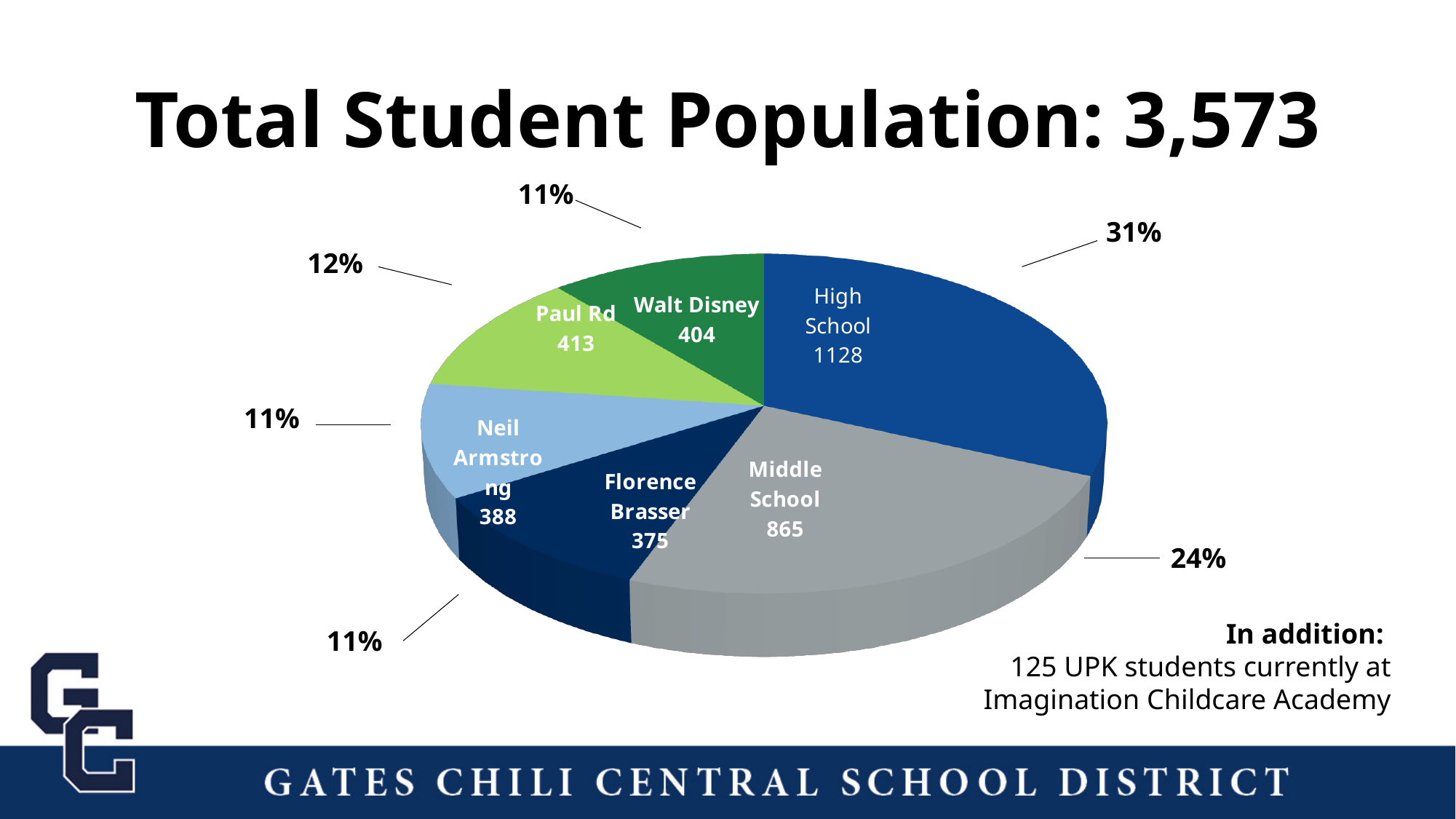
How many students are shown for Middle School? 865 Which is larger, the value for Paul Rd or the value for Walt Disney? Paul Rd What share of the pie does Paul Rd represent? 12% What is the difference between the High School and Middle School values? 263 What is the difference between the Paul Rd and Walt Disney values? 9 How many slices does the pie chart have? 6 What share of the pie does High School represent? 31% What kind of chart is shown on the slide? Pie chart What is the value shown for High School? 1128 What is the value shown for Neil Armstrong? 388 Which slice of the pie chart is the smallest? Florence Brasser Which slice of the pie chart is the largest? High School